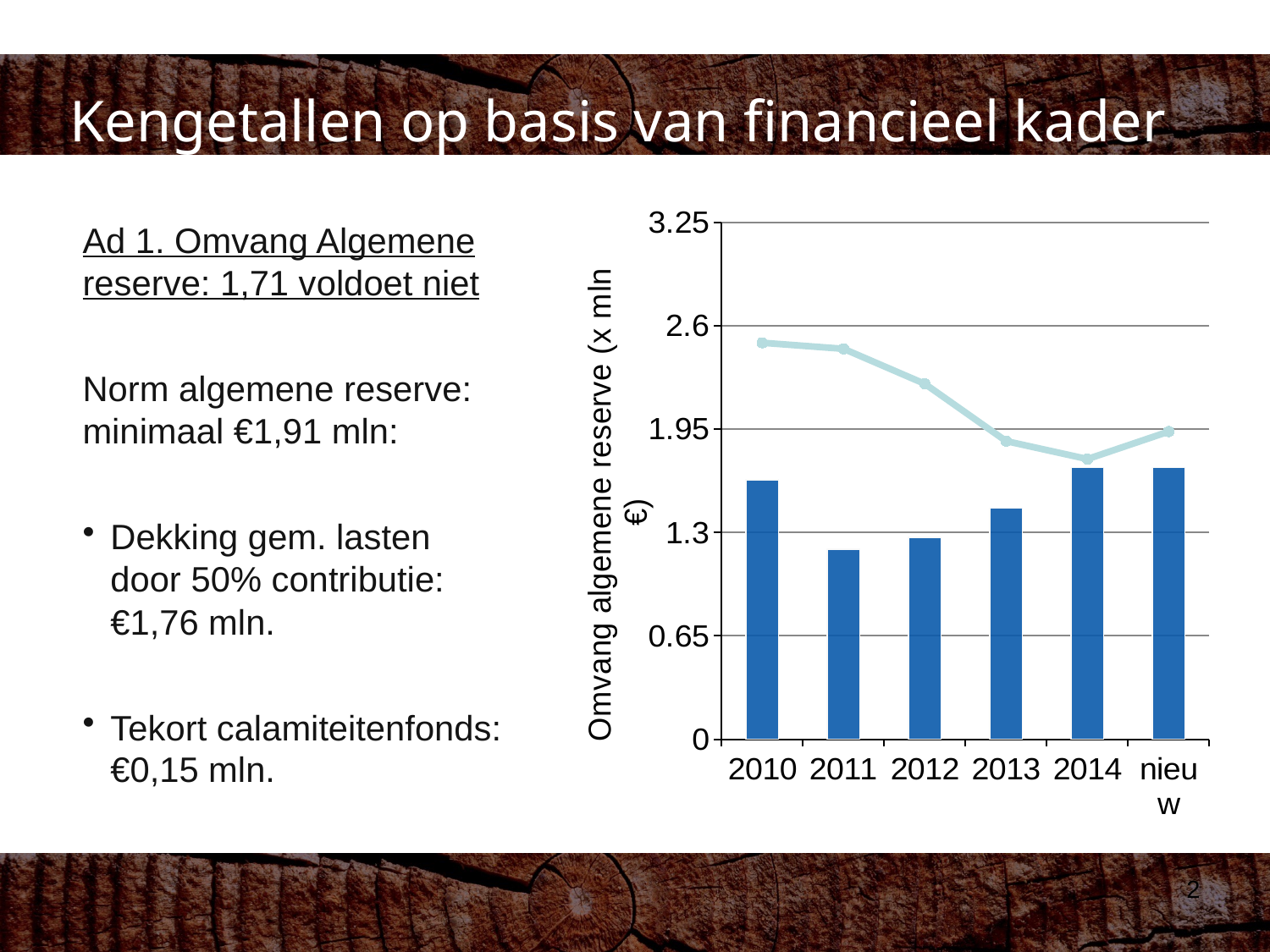
Does the line rise or fall from 2010 to 2014? fall Is the bar value for 2014 greater or less than 1.95? less Is the line value for 2014 greater or less than 1.95? less How many categories are shown on the x axis of the chart? 6 Is the bar value for 2011 greater or less than 1.3? less Which has the taller bar, 2010 or 2011? 2010 What is the title of the vertical axis of the chart? Omvang algemene reserve (x mln €) Which has the taller bar, 2013 or 2012? 2013 What kind of chart is shown on the slide? A bar chart combined with a line